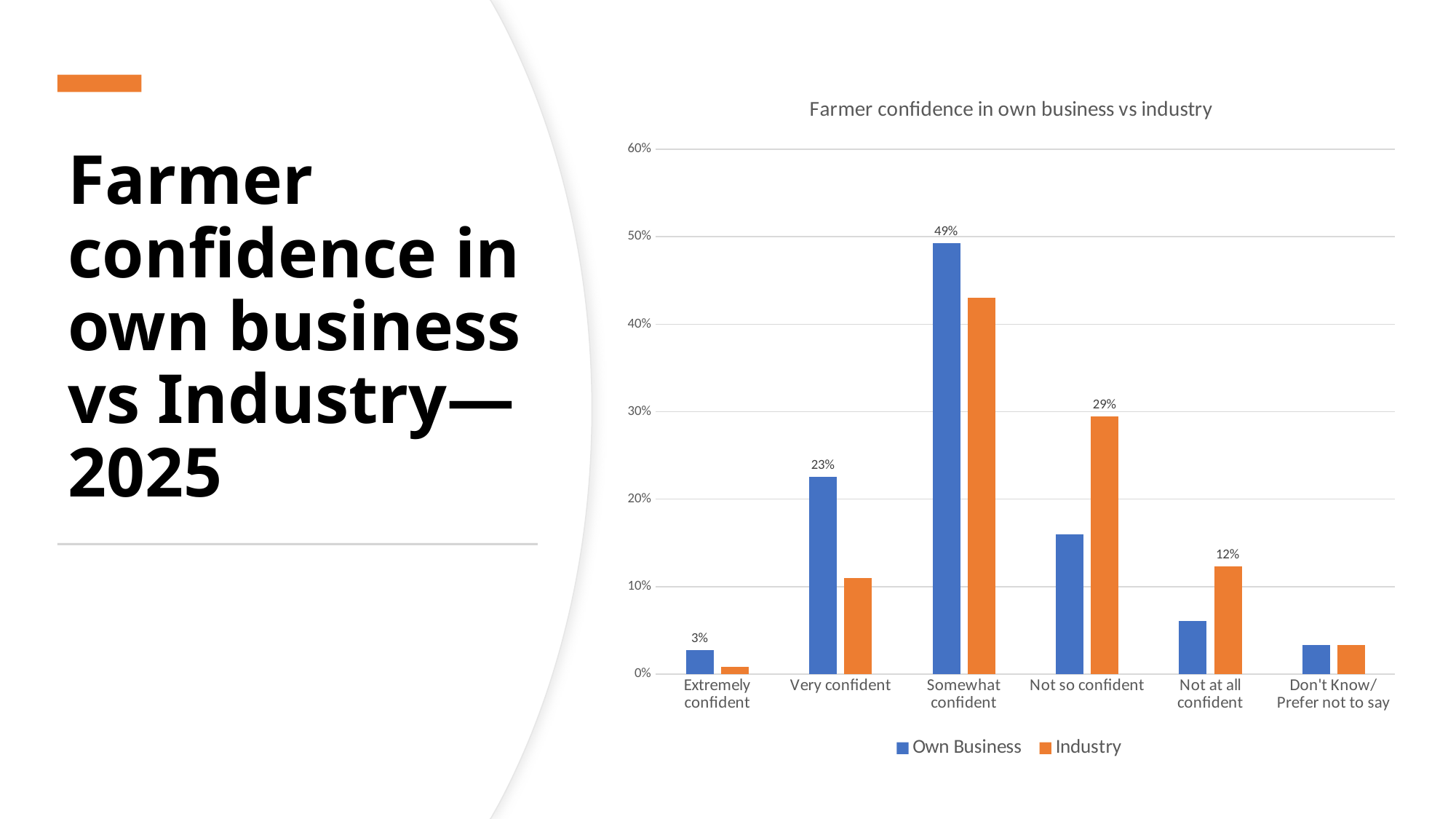
What is the Industry value for Not at all confident? 12% Is the Own Business value for Not so confident greater or less than 20%? less How many categories are shown on the x axis? 6 For Not so confident, which is larger: Own Business or Industry? Industry What is the Own Business value for Extremely confident? 3% What is the Own Business value for Somewhat confident? 49% Is the Industry value for Somewhat confident greater or less than 40%? greater What is the Industry value for Not so confident? 29% How many series does the legend list? 2 Which category has the highest Own Business value? Somewhat confident What is the Own Business value for Very confident? 23% For Very confident, which is larger: Own Business or Industry? Own Business